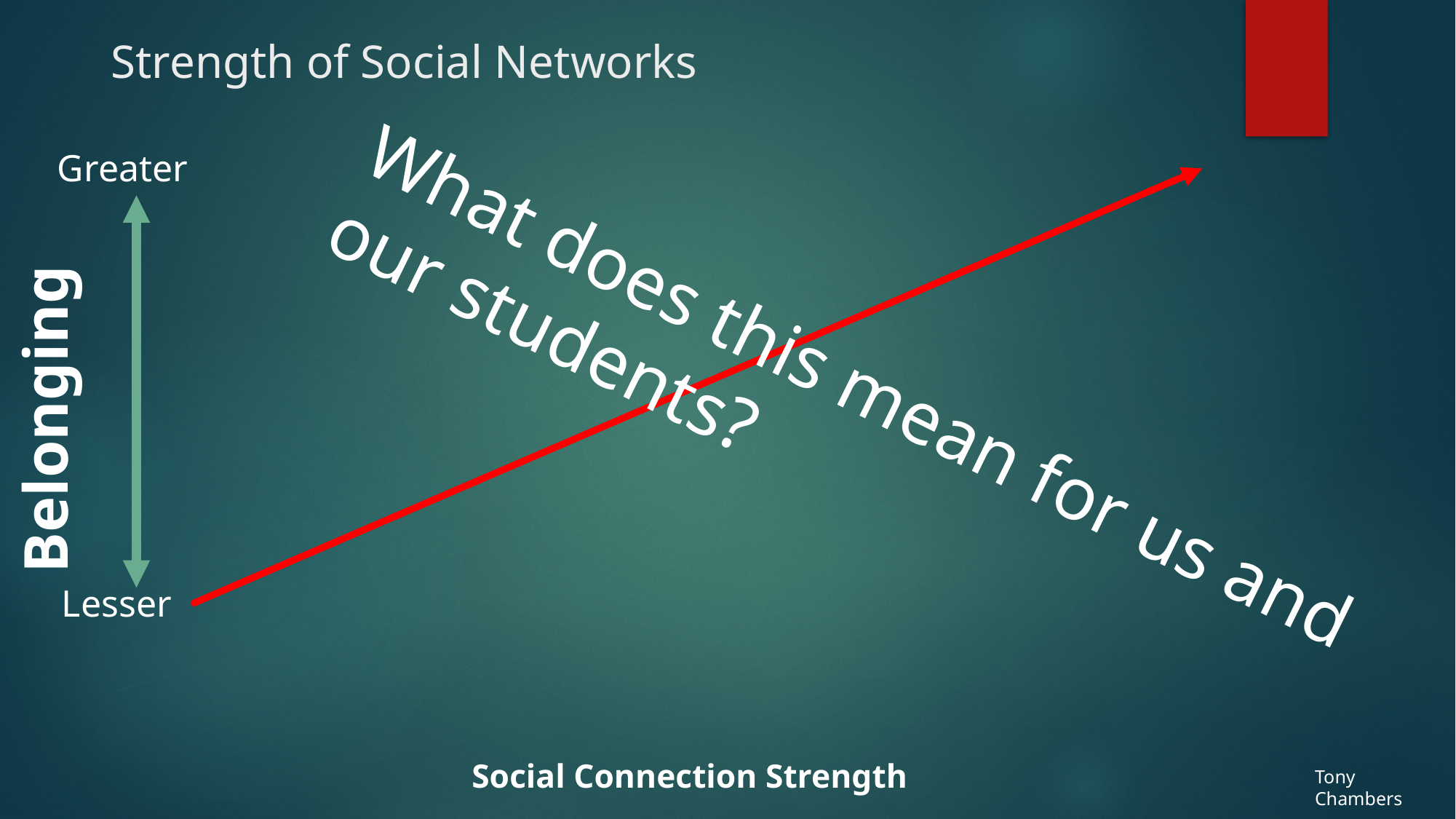
What is the title of the chart on the slide? Strength of Social Networks What label is given to the vertical axis of the chart? Belonging Does the red line rise or fall as Social Connection Strength increases along the x axis? rises